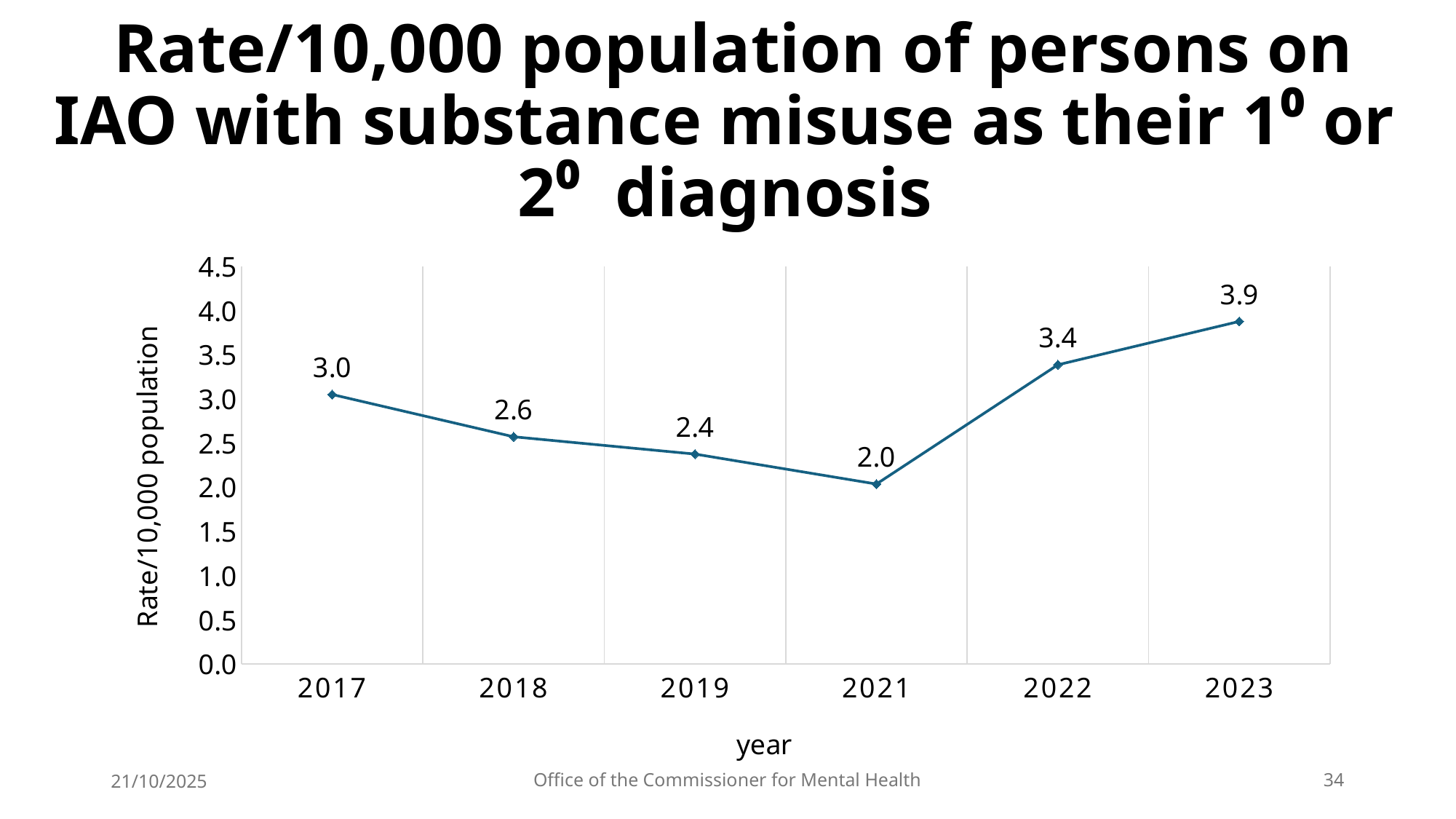
How many years are plotted on the chart? 6 Which year has the lowest rate? 2021 What is the rate per 10,000 population in 2021? 2.0 What kind of chart is shown on the slide? line chart What is the rate per 10,000 population in 2023? 3.9 Which year has a higher rate, 2018 or 2022? 2022 Which year has the highest rate? 2023 What is the difference between the rate in 2023 and the rate in 2021? 1.9 What is the rate per 10,000 population in 2017? 3.0 What is the label of the y axis? Rate/10,000 population Does the rate rise or fall from 2017 to 2021? fall Is the value for 2019 greater or less than 2.5? less